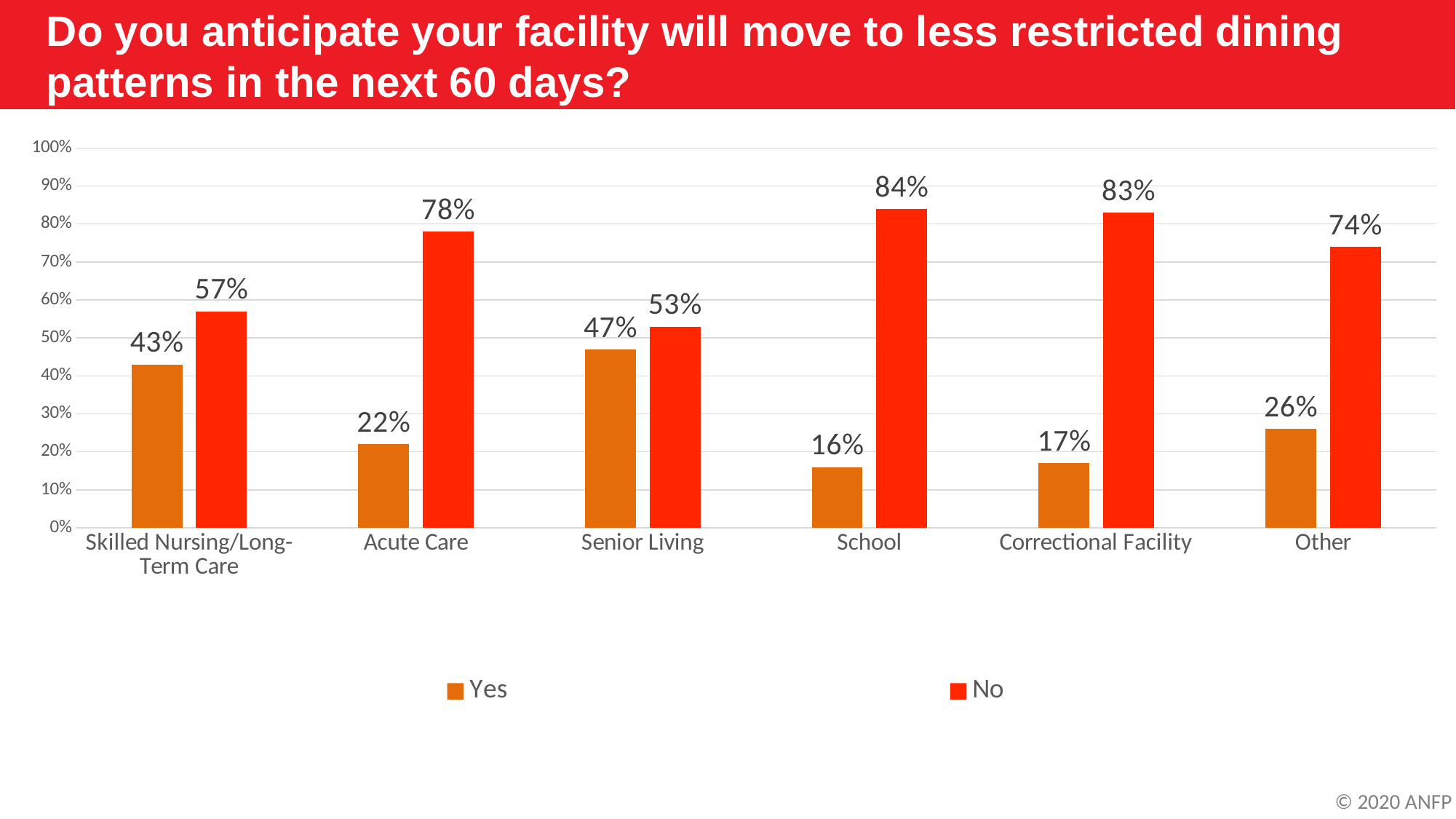
Is the No value for Senior Living greater or less than 50%? greater Which category has the highest No value? School What is the No value for Correctional Facility? 83% Which colour represents the Yes series in the legend? Orange Which category has the lowest Yes value? School How many series does the legend list? 2 What kind of chart is shown on the slide? Bar chart Which is larger for Skilled Nursing/Long-Term Care: the Yes value or the No value? No What is the difference between the No and Yes values for Other? 48% What percentage of Acute Care respondents answered Yes? 22% How many facility categories are shown on the x axis? 6 What is the Yes value for Senior Living? 47%